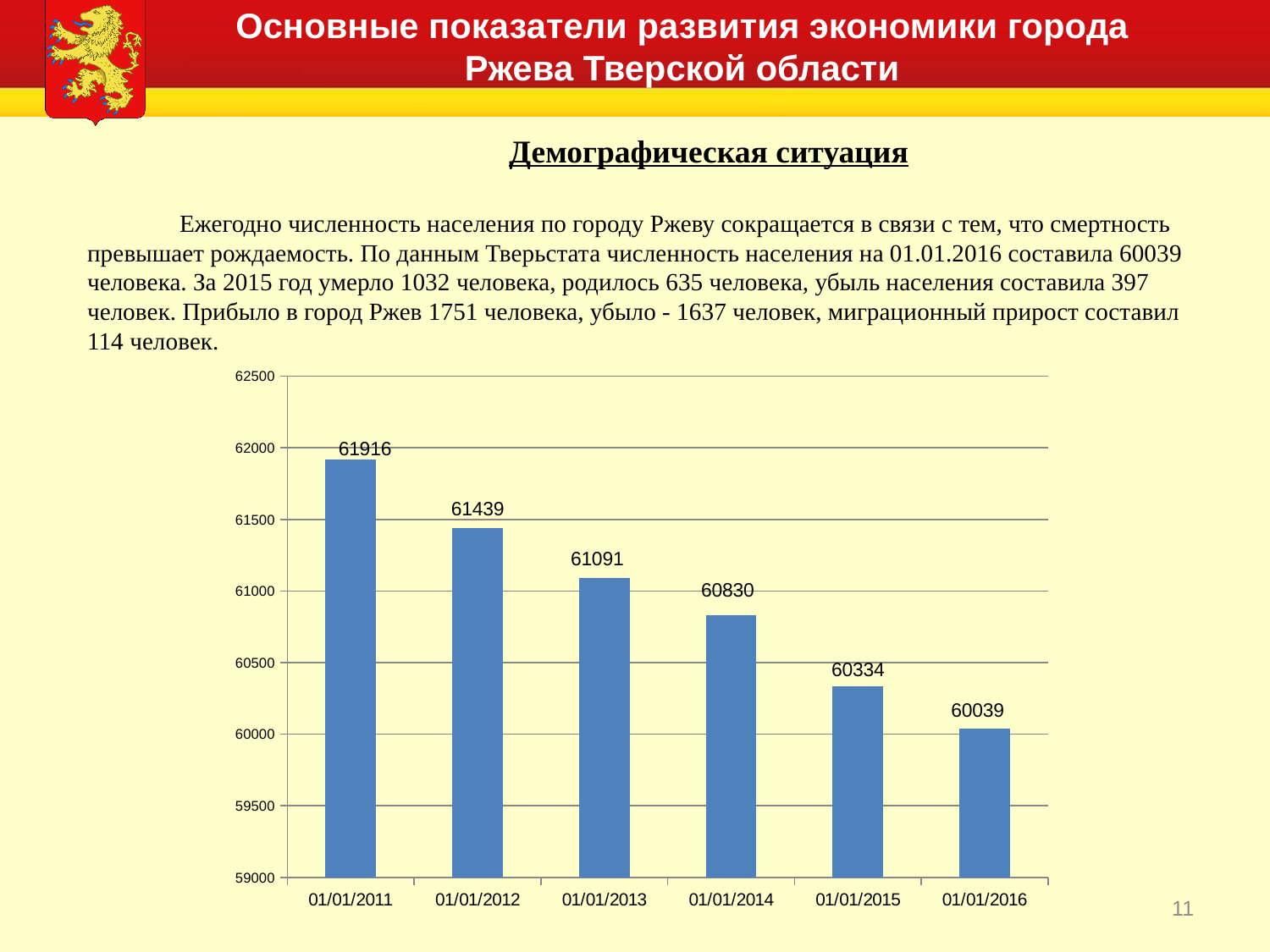
Which date has the lowest value? 01/01/2016 Is the value for 01/01/2014 greater or less than 61000? less Which is larger, the value for 01/01/2013 or the value for 01/01/2015? 01/01/2013 Which date has the highest value? 01/01/2011 Do the values rise or fall from 01/01/2011 to 01/01/2016? fall How many bars are shown in the chart? 6 What is the value for 01/01/2016? 60039 What is the difference between the values for 01/01/2012 and 01/01/2013? 348 What kind of chart is shown on the slide? bar chart What is the value for 01/01/2011? 61916 What is the value for 01/01/2014? 60830 What is the difference between the values for 01/01/2011 and 01/01/2016? 1877